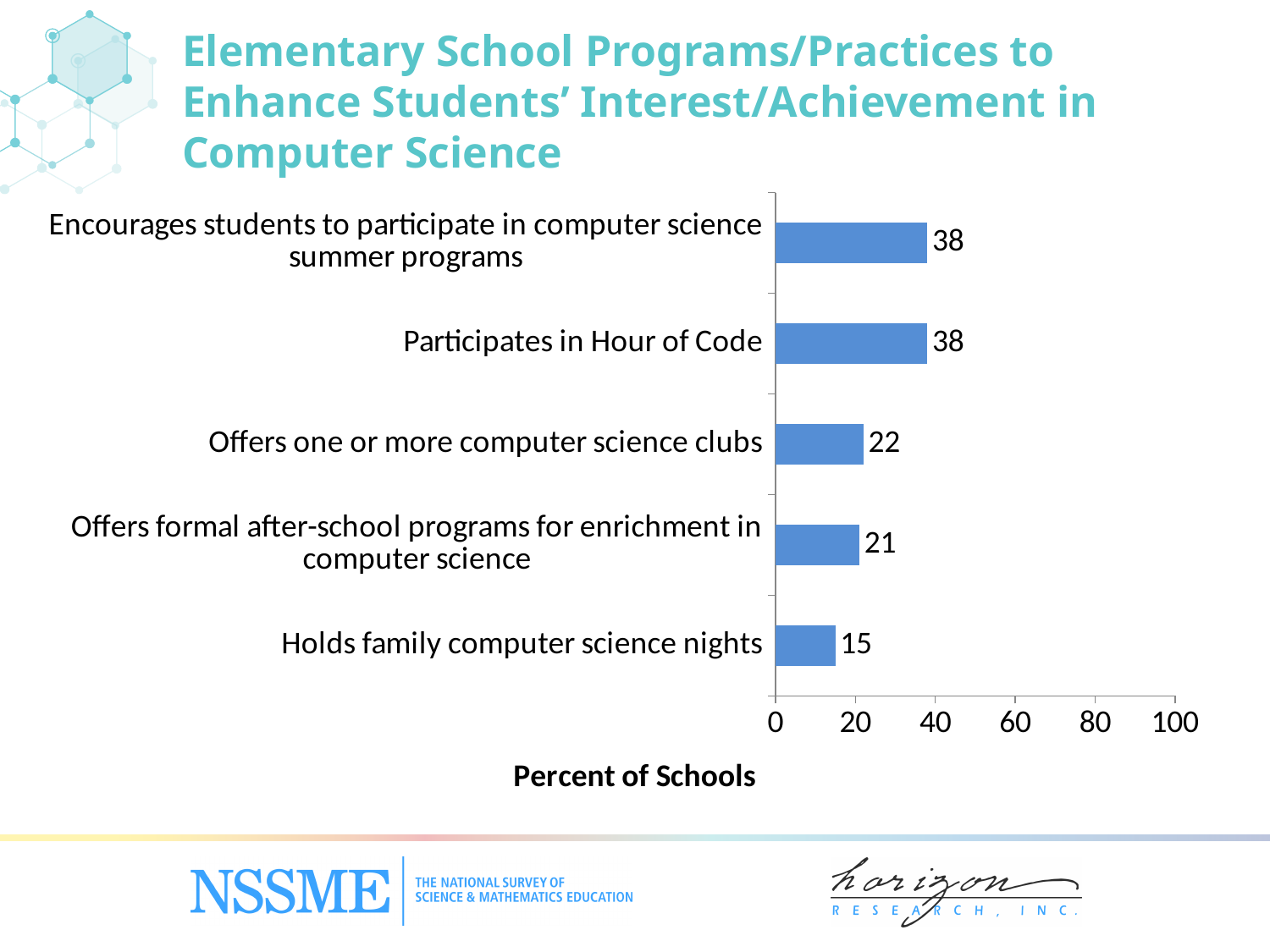
Which is larger: the percent of schools that encourage students to participate in computer science summer programs or the percent that hold family computer science nights? Encourages students to participate in computer science summer programs What percent of schools offer formal after-school programs for enrichment in computer science? 21 What is the difference in percent of schools between participating in Hour of Code and holding family computer science nights? 23 What percent of schools offer one or more computer science clubs? 22 Is the value for Participates in Hour of Code greater or less than 40? less What kind of chart is shown on the slide? Bar chart What percent of schools hold family computer science nights? 15 What is the difference in percent of schools between offering computer science clubs and offering formal after-school programs for enrichment in computer science? 1 What is the label of the horizontal axis? Percent of Schools What percent of schools participate in Hour of Code? 38 Which program/practice has the lowest percent of schools? Holds family computer science nights How many programs/practices are shown in the chart? 5